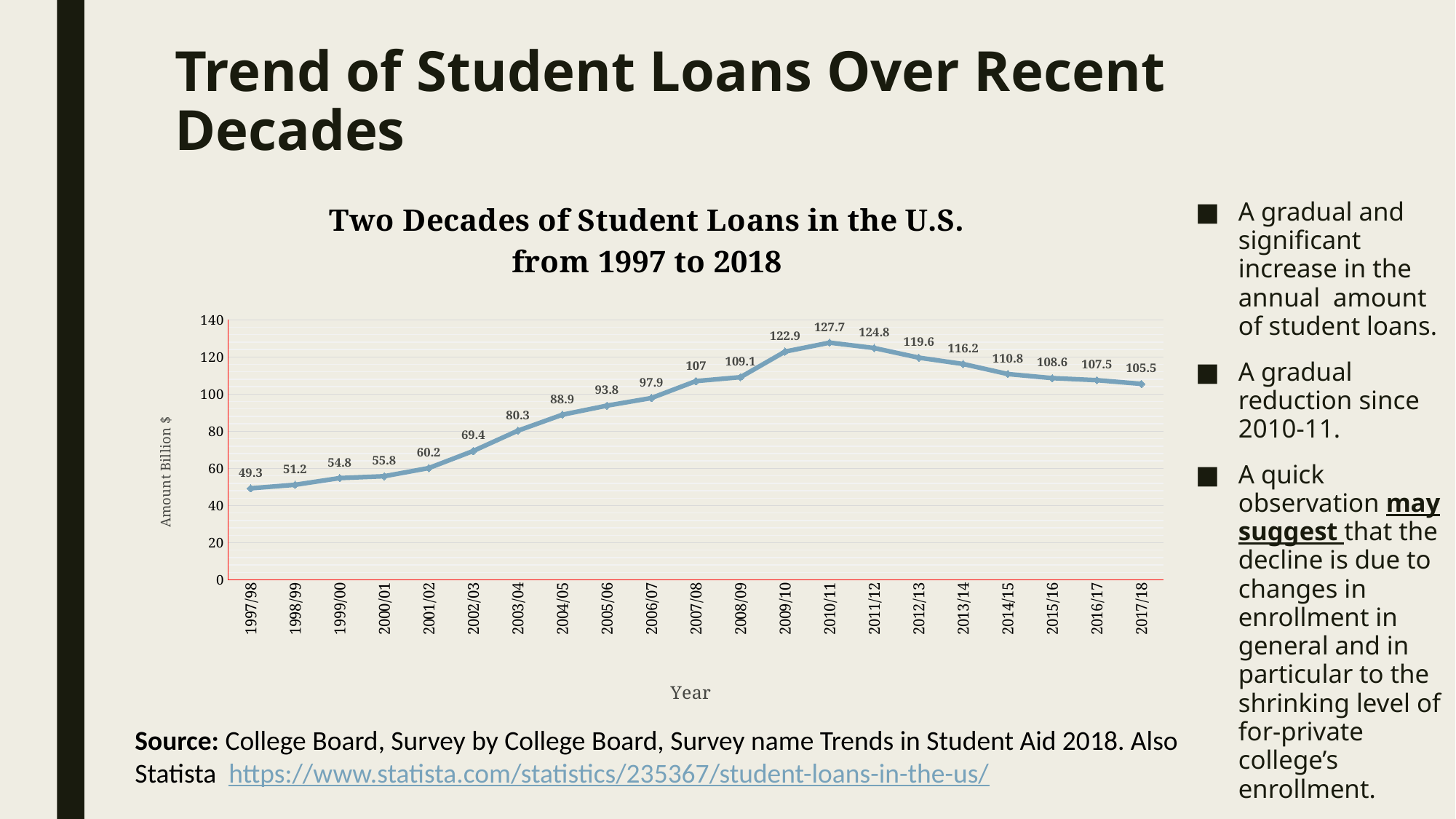
What is the difference between the values for 2010/11 and 2017/18? 22.2 What is the value for 1997/98? 49.3 Which is larger, the value for 2003/04 or the value for 2008/09? 2008/09 Which year has the lowest value? 1997/98 Which year has the highest value? 2010/11 What kind of chart is shown? line chart What is the label of the y axis? Amount Billion $ What is the value for 2017/18? 105.5 What is the value for 2010/11? 127.7 How many years are plotted on the x axis? 21 Is the value for 2009/10 greater or less than 120? greater Do the values rise or fall from 1997/98 to 2010/11? rise